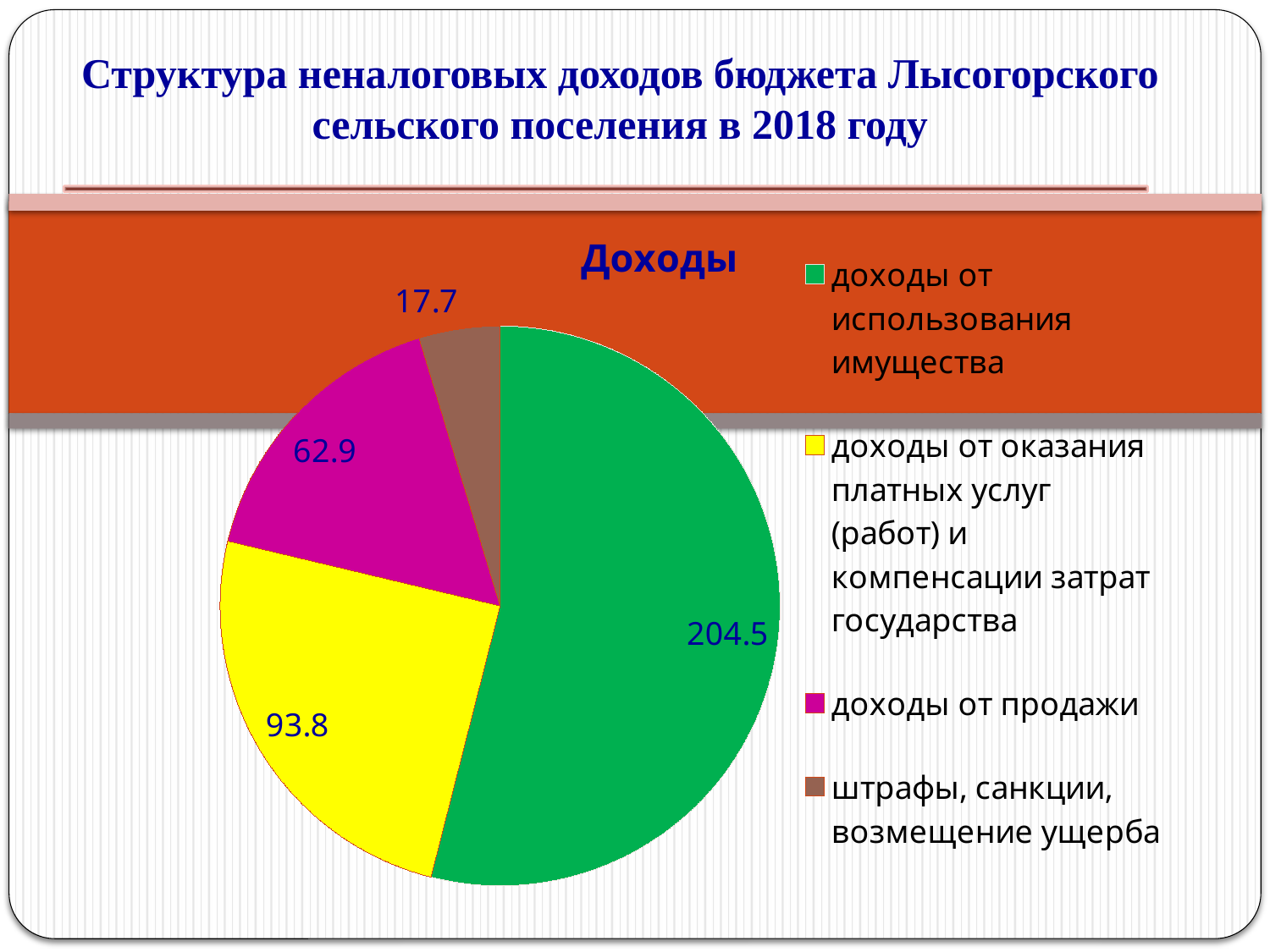
How many entries does the legend list? 4 What type of chart is shown on the slide? pie chart What is the value for 'штрафы, санкции, возмещение ущерба'? 17.7 Which category has the smallest slice of the pie? штрафы, санкции, возмещение ущерба Which category has the largest slice of the pie? доходы от использования имущества Which is larger: 'доходы от продажи' or 'штрафы, санкции, возмещение ущерба'? доходы от продажи How many slices does the pie chart have? 4 What is the value for 'доходы от оказания платных услуг (работ) и компенсации затрат государства'? 93.8 What is the value for 'доходы от использования имущества'? 204.5 What is the value for 'доходы от продажи'? 62.9 What is the title of the chart? Доходы What is the difference between the values for 'доходы от использования имущества' and 'доходы от оказания платных услуг (работ) и компенсации затрат государства'? 110.7